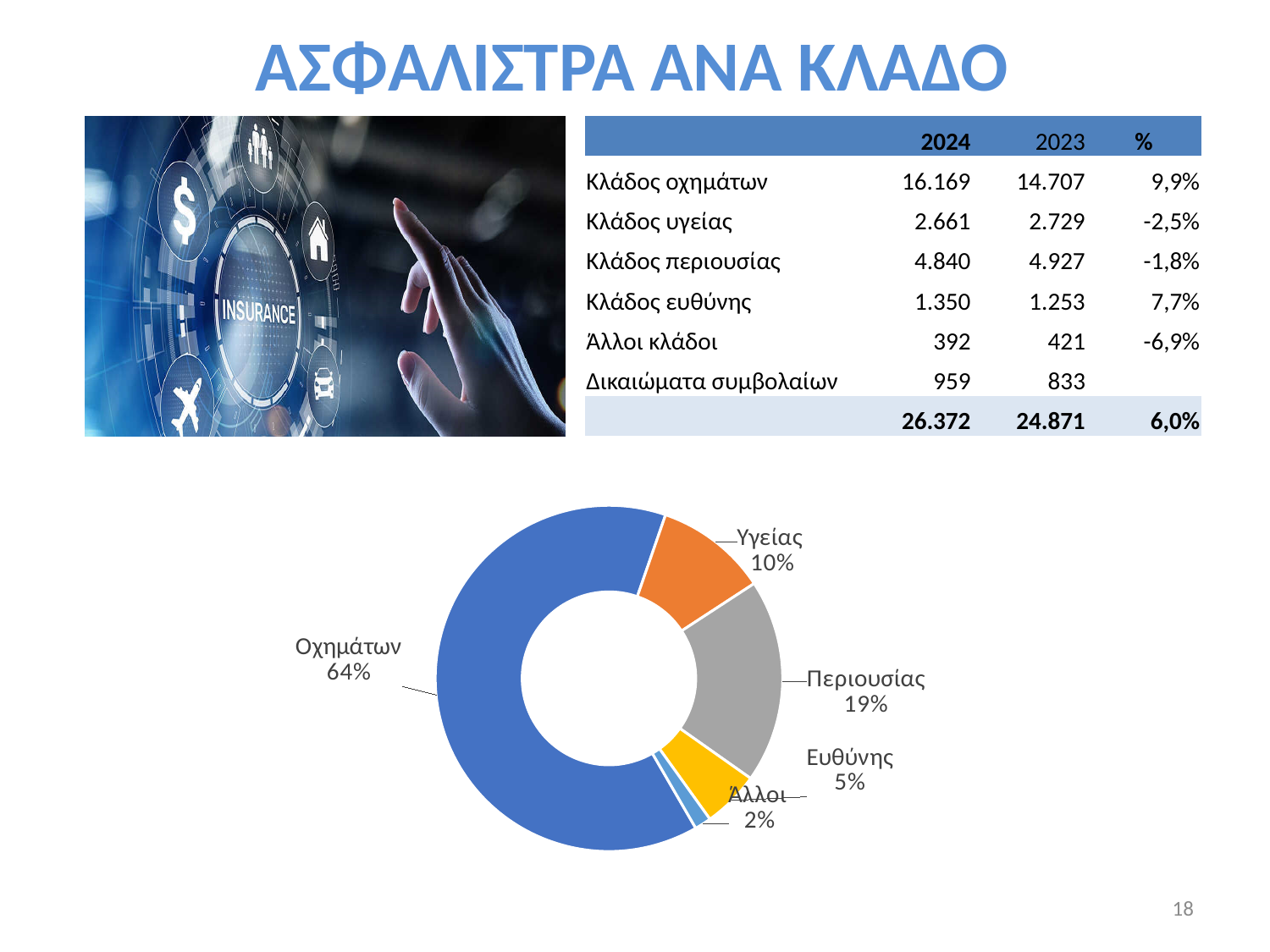
What share of the doughnut chart does Υγείας hold? 10% What share of the doughnut chart does Οχημάτων hold? 64% What colour is the Υγείας slice in the doughnut chart? Orange What share of the doughnut chart does Άλλοι hold? 2% In the doughnut chart, which is larger: Υγείας or Περιουσίας? Περιουσίας What kind of chart is shown on the slide? Doughnut (pie) chart Which slice of the doughnut chart is the largest? Οχημάτων Which slice of the doughnut chart is the smallest? Άλλοι In the doughnut chart, what is the difference in percentage points between Οχημάτων and Περιουσίας? 45 percentage points How many slices does the doughnut chart have? 5